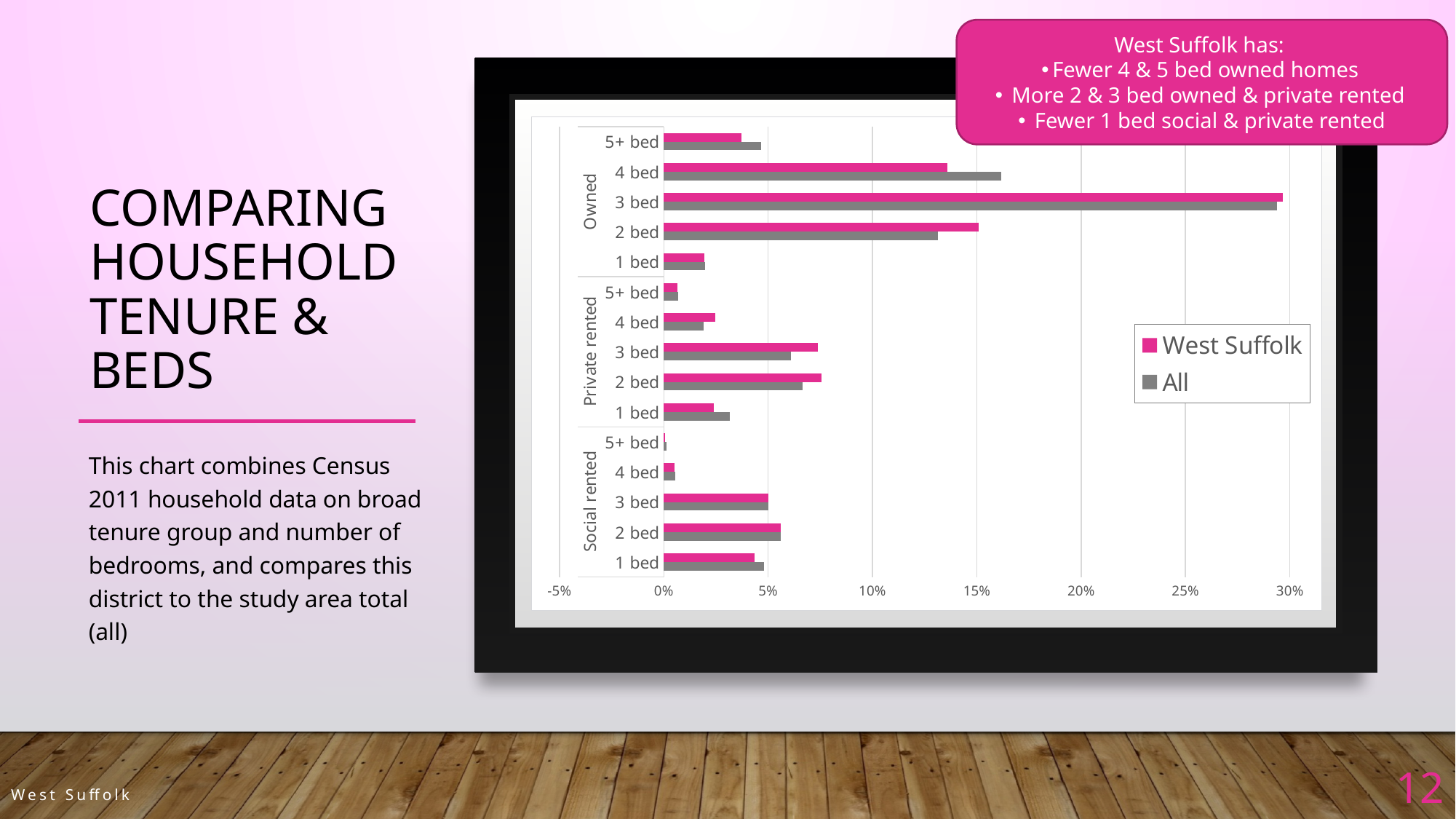
Which category has the highest value for West Suffolk? Owned, 3 bed For Owned 4 bed, which series has the larger value, West Suffolk or All? All Is the All value for Owned 4 bed greater or less than 15%? greater For Private rented 1 bed, which series has the larger value, West Suffolk or All? All How many tenure groups are shown on the chart's vertical axis? 3 Which two series are listed in the chart legend? West Suffolk and All Which category has the lowest value for West Suffolk? Social rented, 5+ bed What kind of chart is shown on the slide? Bar chart How many series does the chart legend list? 2 How many bedroom categories are shown within each tenure group? 5 Is the West Suffolk value for Owned 3 bed greater or less than 25%? greater Is the West Suffolk value for Private rented 2 bed greater or less than 5%? greater